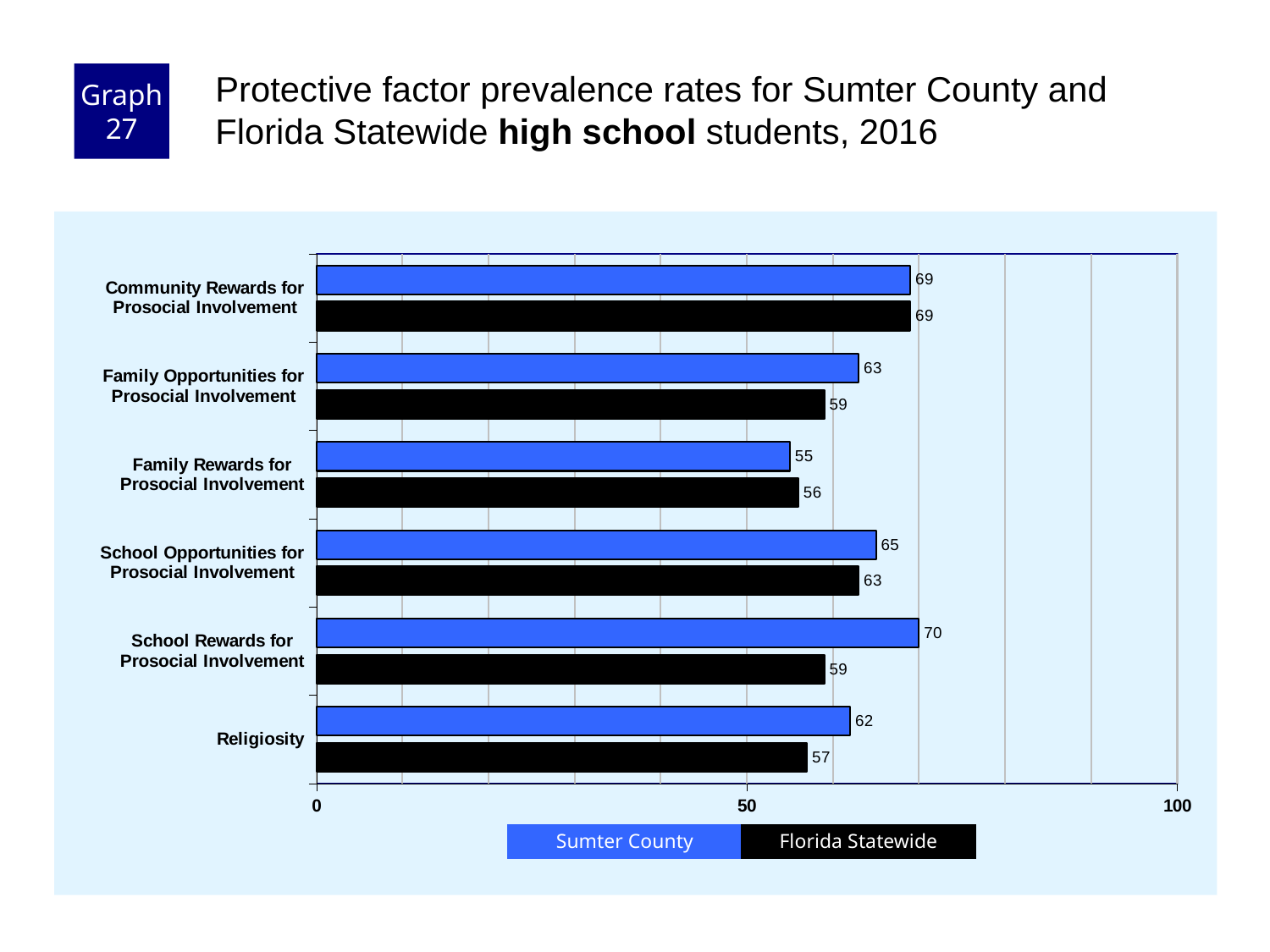
What is the difference between the Sumter County and Florida Statewide values for School Rewards for Prosocial Involvement? 11 Which category has the highest Sumter County value? School Rewards for Prosocial Involvement Which is larger for Religiosity, the Sumter County value or the Florida Statewide value? Sumter County What kind of chart is shown on the slide? Bar chart What is the Sumter County value for School Rewards for Prosocial Involvement? 70 What is the Florida Statewide value for Family Opportunities for Prosocial Involvement? 59 How many categories are shown on the chart? 6 What is the Florida Statewide value for Religiosity? 57 Which colour represents Florida Statewide in the chart? Black Which category has the highest Florida Statewide value? Community Rewards for Prosocial Involvement How many series does the legend list? 2 Which category has the lowest Sumter County value? Family Rewards for Prosocial Involvement